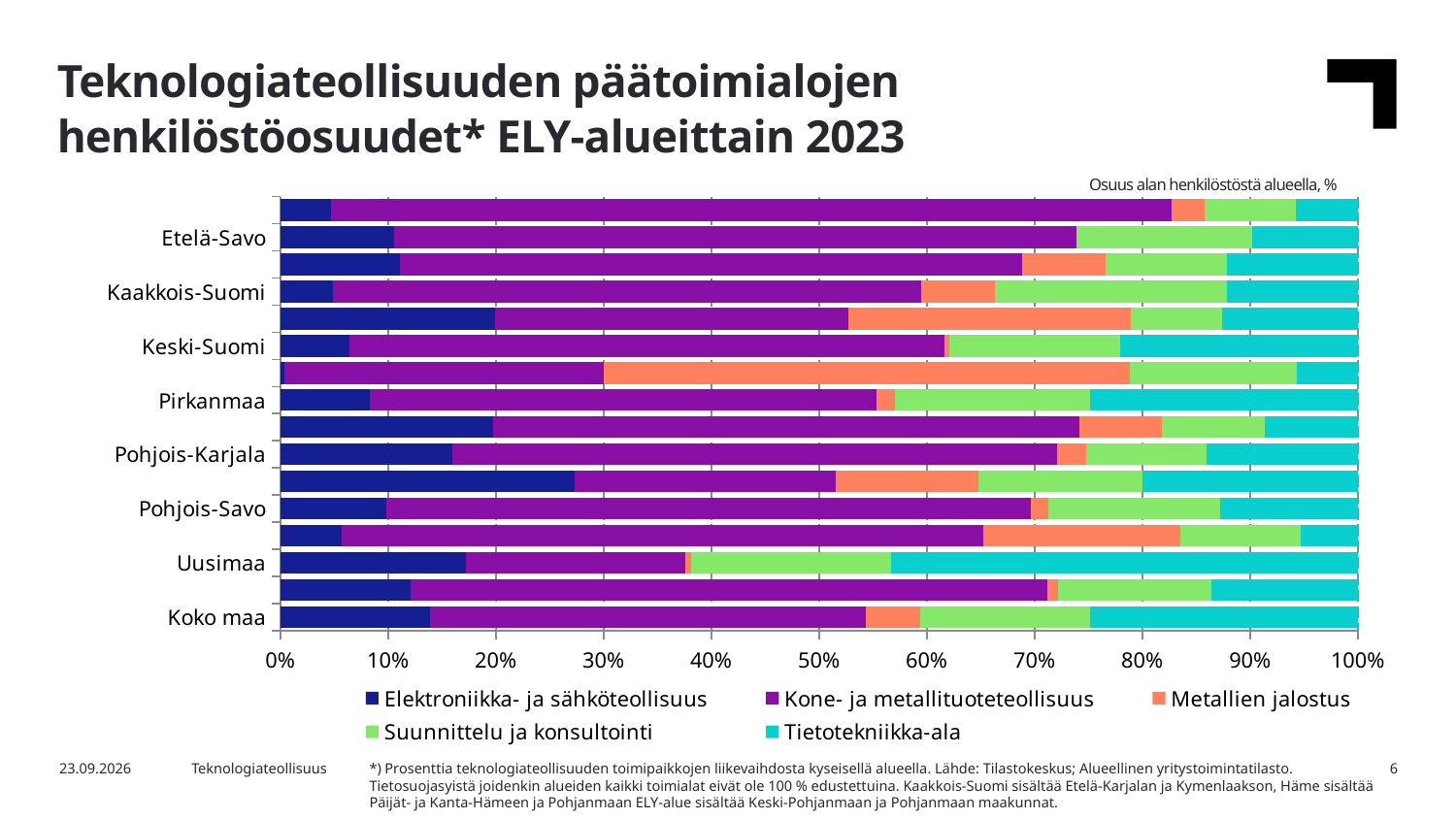
How many series does the legend list? 5 What is the maximum value shown on the horizontal axis? 100% Which has the larger Kone- ja metallituoteteollisuus share, Uusimaa or Etelä-Savo? Etelä-Savo Is the Tietotekniikka-ala share for Uusimaa greater or less than 30%? greater Is the Kone- ja metallituoteteollisuus share for Pohjois-Karjala greater or less than 50%? greater Among the labelled regions, which has the largest Tietotekniikka-ala share? Uusimaa What kind of chart is shown on the slide? Stacked bar chart Which series is shown in orange in the legend? Metallien jalostus Which has the larger Tietotekniikka-ala share, Uusimaa or Koko maa? Uusimaa Is the Elektroniikka- ja sähköteollisuus share for Koko maa greater or less than 10%? greater